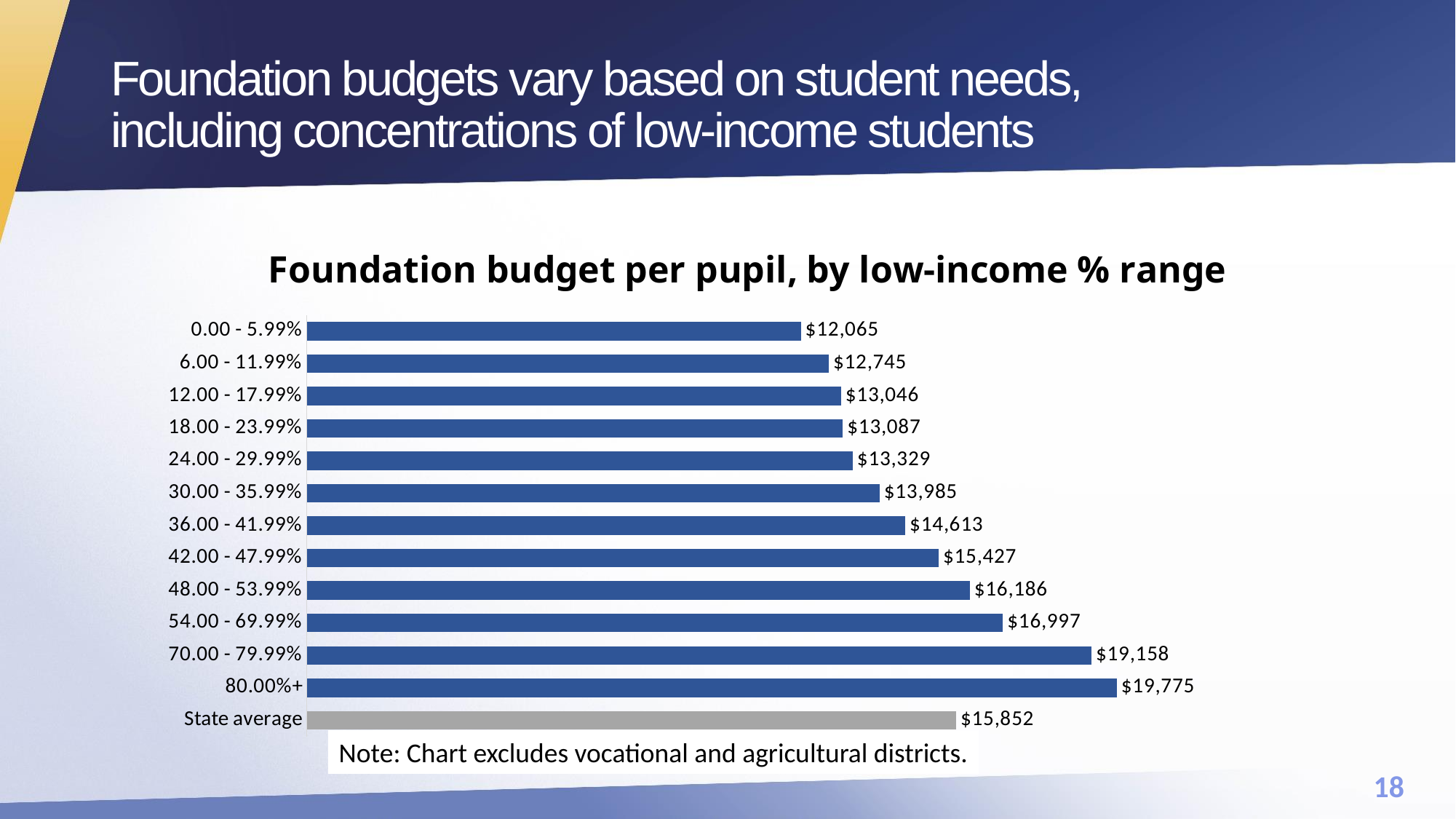
Which is larger: the foundation budget per pupil for the 48.00 - 53.99% range or the State average? 48.00 - 53.99% What is the difference between the foundation budget per pupil for the 80.00%+ range and the 0.00 - 5.99% range? $7,710 Which bar on the chart is coloured grey rather than blue? State average What is the foundation budget per pupil for the 42.00 - 47.99% range? $15,427 Which low-income % range has the lowest foundation budget per pupil? 0.00 - 5.99% What is the foundation budget per pupil for the 80.00%+ low-income range? $19,775 Which low-income % range has the highest foundation budget per pupil? 80.00%+ What type of chart is shown on the slide? Bar chart What is the difference between the foundation budget per pupil for the 70.00 - 79.99% range and the State average? $3,306 What is the State average foundation budget per pupil shown on the chart? $15,852 What is the foundation budget per pupil for the 0.00 - 5.99% low-income range? $12,065 How many bars are shown on the chart, including the State average? 13